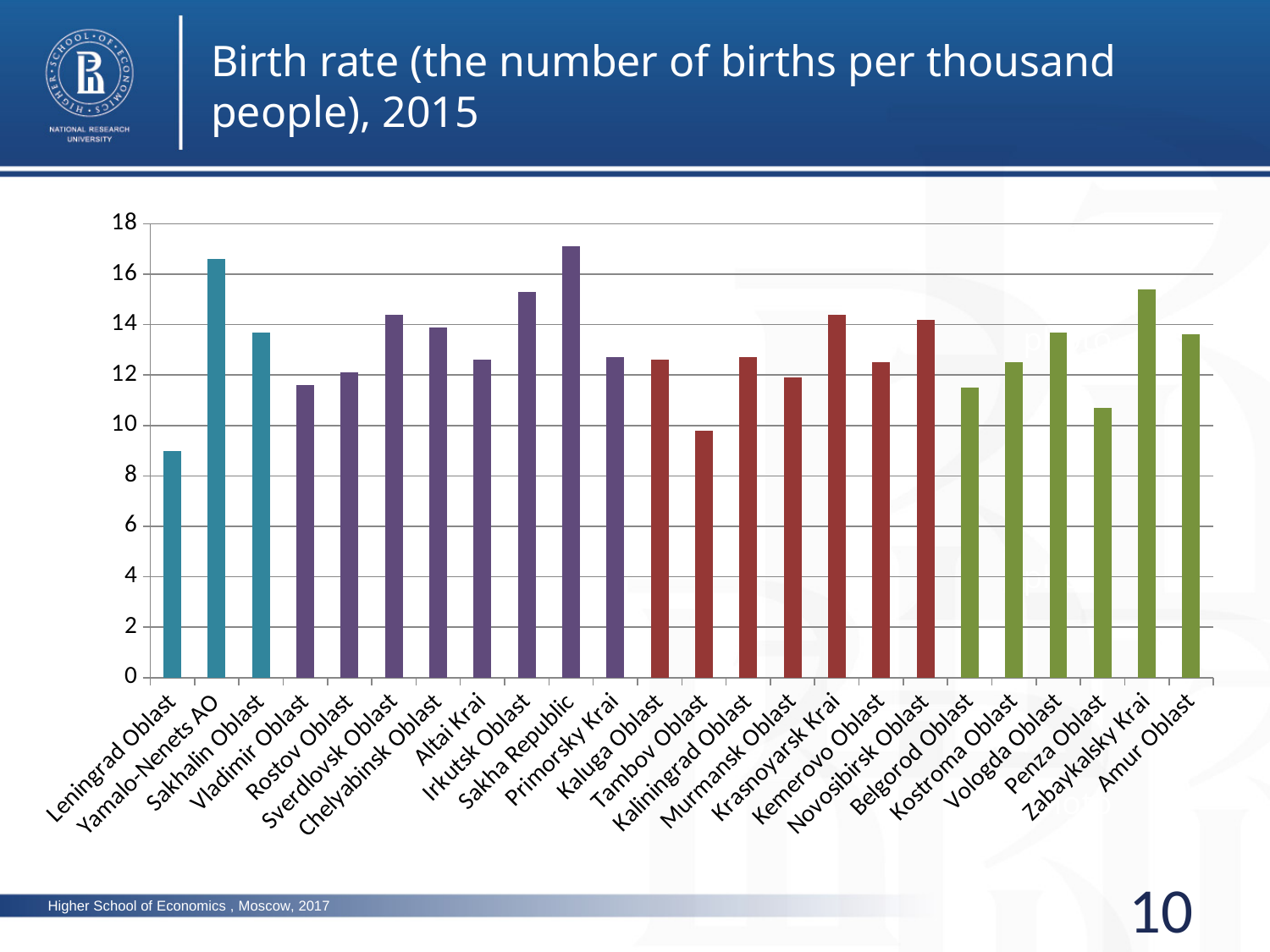
Is the value for Leningrad Oblast greater or less than 10? less How many regions are plotted in the chart? 24 Which region has the lowest birth rate in the chart? Leningrad Oblast Is the value for Sakha Republic greater or less than 16? greater Which region has the highest birth rate in the chart? Sakha Republic Which has a higher birth rate, Yamalo-Nenets AO or Sakhalin Oblast? Yamalo-Nenets AO Is the value for Tambov Oblast greater or less than 10? less What is the title of the chart on the slide? Birth rate (the number of births per thousand people), 2015 Which has a higher birth rate, Krasnoyarsk Krai or Tambov Oblast? Krasnoyarsk Krai What kind of chart is shown on the slide? bar chart How many different bar colours are used in the chart? 4